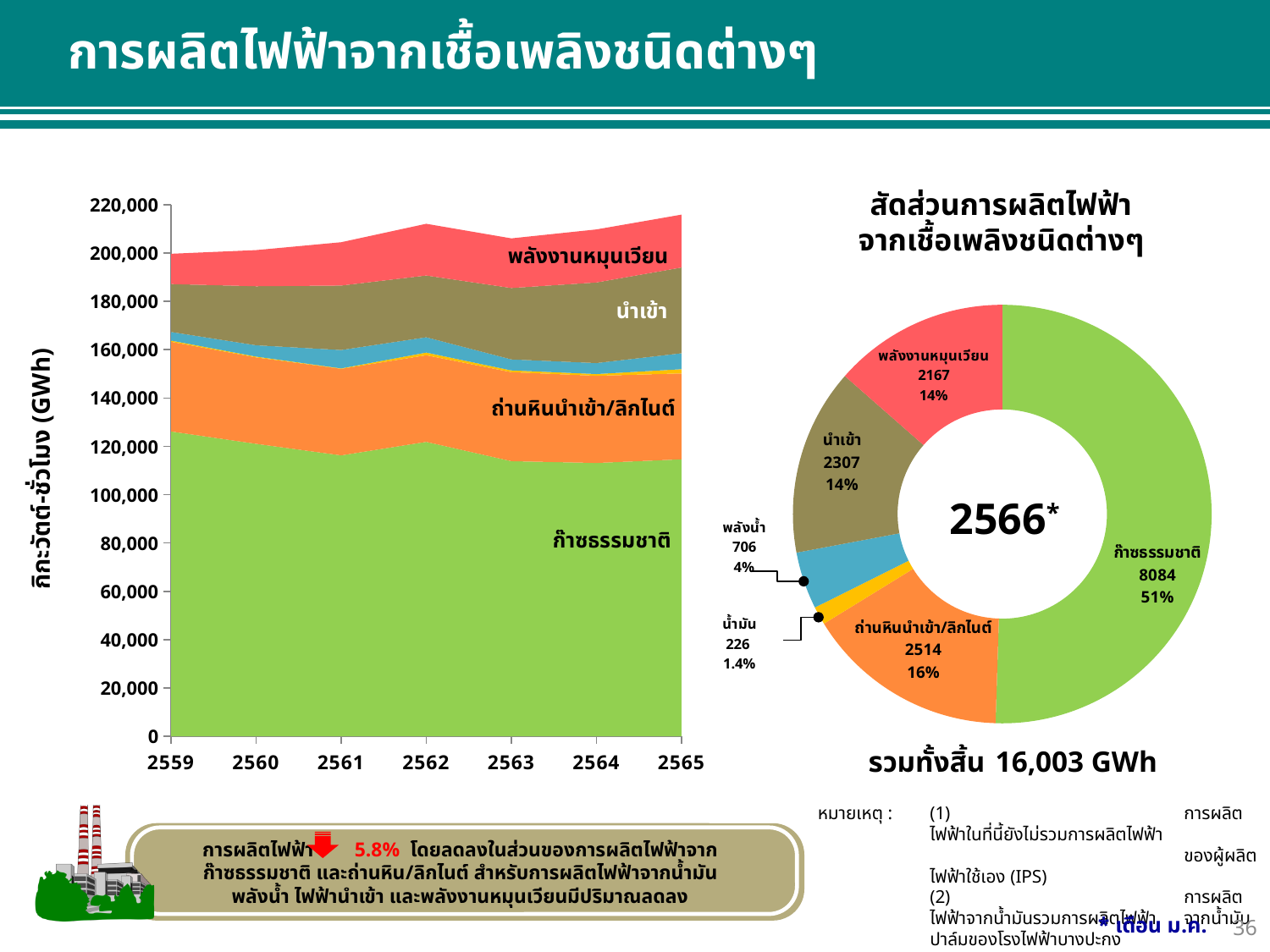
In the donut chart สัดส่วนการผลิตไฟฟ้าจากเชื้อเพลิงชนิดต่างๆ, what is the difference between the values for นำเข้า and พลังงานหมุนเวียน? 140 In the stacked area chart on the left, how many years are shown on the x axis? 7 What type of chart is the chart titled สัดส่วนการผลิตไฟฟ้าจากเชื้อเพลิงชนิดต่างๆ? donut (pie) chart In the donut chart สัดส่วนการผลิตไฟฟ้าจากเชื้อเพลิงชนิดต่างๆ, which fuel has the smallest slice? น้ำมัน What type of chart is the chart on the left of the slide? stacked area chart In the donut chart สัดส่วนการผลิตไฟฟ้าจากเชื้อเพลิงชนิดต่างๆ, what share does ถ่านหินนำเข้า/ลิกไนต์ have? 16% In the donut chart สัดส่วนการผลิตไฟฟ้าจากเชื้อเพลิงชนิดต่างๆ, which fuel has the largest slice? ก๊าซธรรมชาติ In the donut chart สัดส่วนการผลิตไฟฟ้าจากเชื้อเพลิงชนิดต่างๆ, which is larger, พลังน้ำ or น้ำมัน? พลังน้ำ In the donut chart สัดส่วนการผลิตไฟฟ้าจากเชื้อเพลิงชนิดต่างๆ, what is the value for ก๊าซธรรมชาติ? 8084 In the donut chart สัดส่วนการผลิตไฟฟ้าจากเชื้อเพลิงชนิดต่างๆ, how many fuel categories are shown? 6 What total is stated below the donut chart สัดส่วนการผลิตไฟฟ้าจากเชื้อเพลิงชนิดต่างๆ? 16,003 GWh In the stacked area chart on the left, is the value for ก๊าซธรรมชาติ in 2561 greater or less than 120,000? less